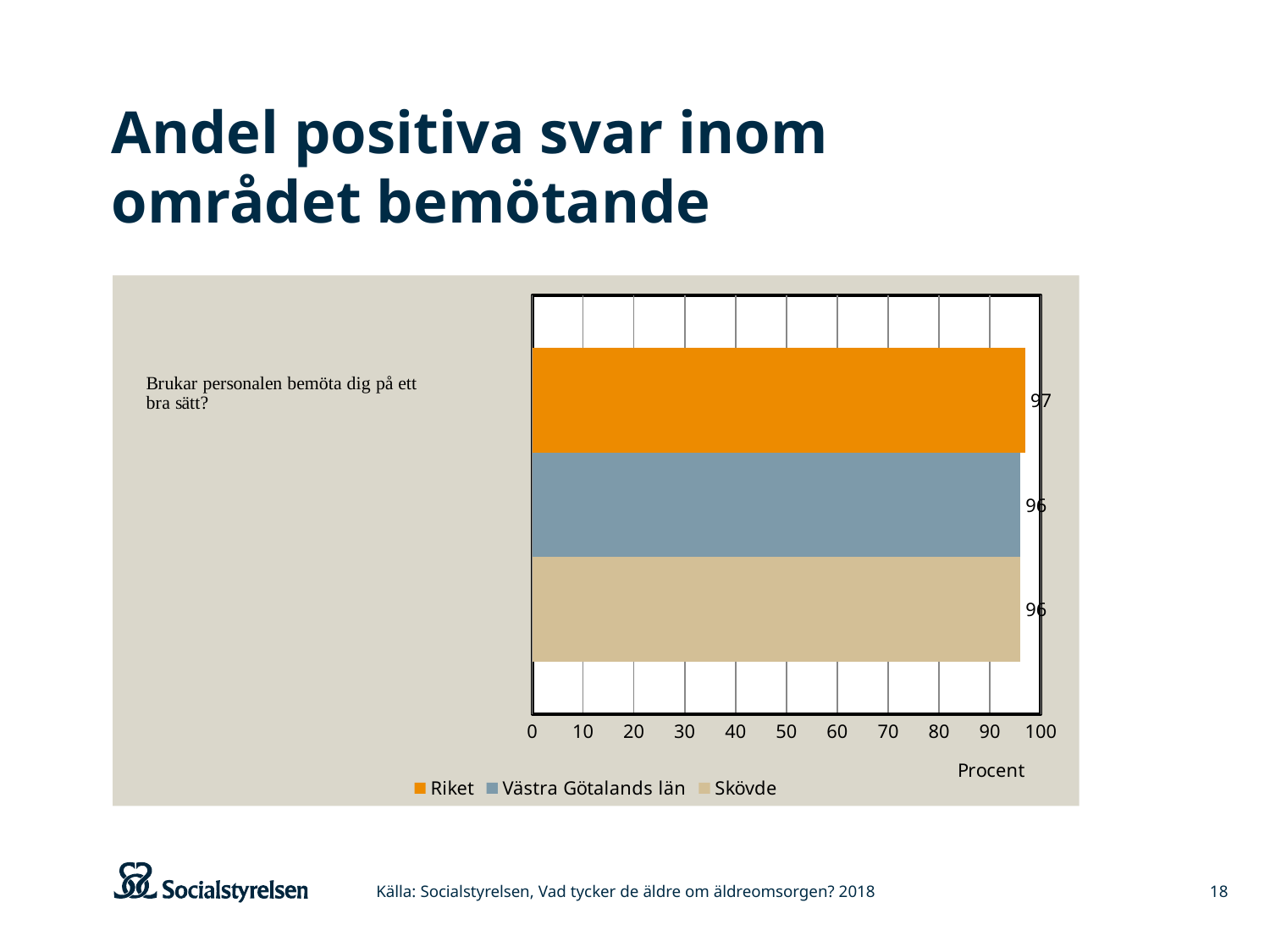
Which series has the highest value? Riket What kind of chart is shown on the slide? bar chart What is the value for Skövde? 96 What is the label of the x axis? Procent What is the question shown as the category label next to the chart? Brukar personalen bemöta dig på ett bra sätt? What is the difference between the values for Riket and Skövde? 1 Is the value for Skövde greater or less than 90? greater Which is larger, the value for Riket or the value for Västra Götalands län? Riket What is the value for Västra Götalands län? 96 What is the value for Riket? 97 How many series does the legend list? 3 What is the maximum value shown on the x axis? 100